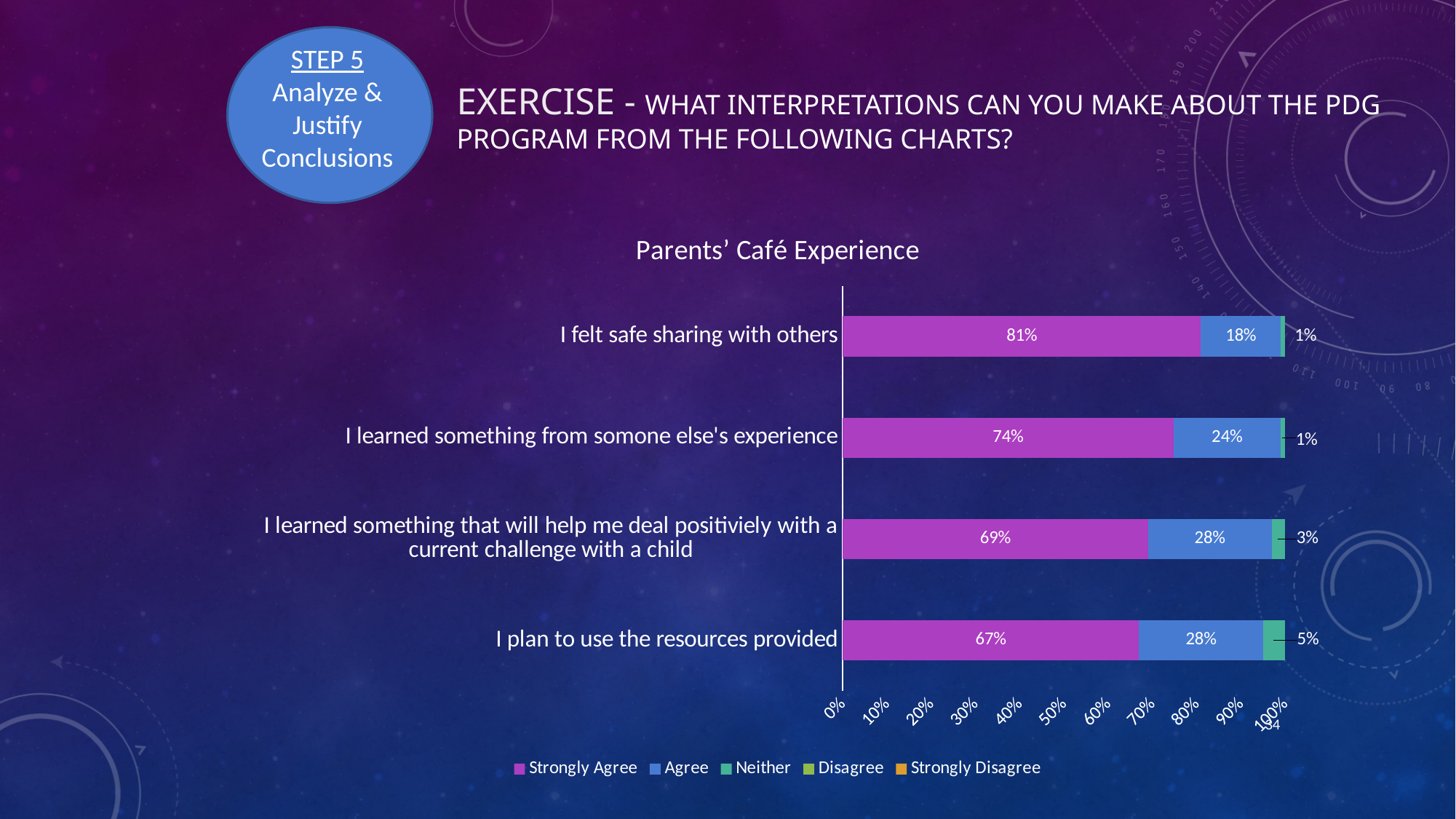
Which has a larger Agree value: "I learned something from somone else's experience" or "I felt safe sharing with others"? I learned something from somone else's experience What is the Neither value for "I learned something that will help me deal positiviely with a current challenge with a child"? 3% What is the difference in Strongly Agree percentage between "I felt safe sharing with others" and "I plan to use the resources provided"? 14 percentage points Which statement has the lowest Strongly Agree percentage? I plan to use the resources provided What kind of chart is shown on the slide? Stacked bar chart Which statement has the highest Strongly Agree percentage? I felt safe sharing with others How many series does the legend list? 5 What is the Agree value for "I plan to use the resources provided"? 28% Is the Strongly Agree value for "I learned something that will help me deal positiviely with a current challenge with a child" greater or less than 50%? greater What percentage of parents strongly agreed with "I felt safe sharing with others"? 81% What is the title of the chart? Parents' Café Experience How many statements are shown in the chart? 4